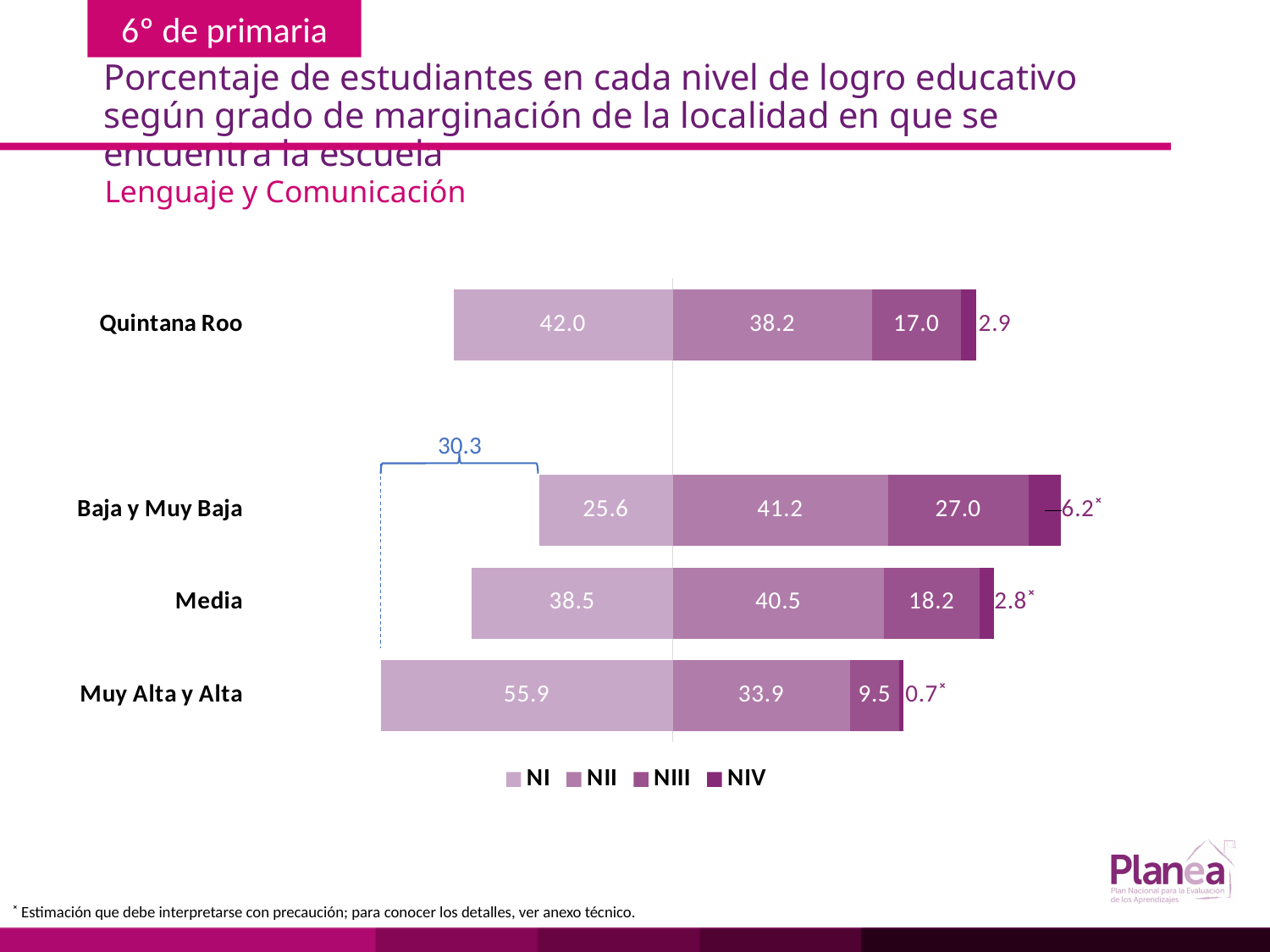
Which has a larger NII value, Quintana Roo or Baja y Muy Baja? Baja y Muy Baja How many series does the legend list? 4 What is the difference between the NI value for Muy Alta y Alta and the NI value for Baja y Muy Baja? 30.3 What is the NII value for Media? 40.5 How many categories are shown on the chart? 4 Which category has the highest NI value? Muy Alta y Alta Which category has the lowest NI value? Baja y Muy Baja What is the NIII value for Muy Alta y Alta? 9.5 What is the difference between the NIII value for Baja y Muy Baja and the NIII value for Media? 8.8 What is the NI value for Quintana Roo? 42.0 What kind of chart is shown on the slide? Stacked bar chart What is the NIV value for Baja y Muy Baja? 6.2